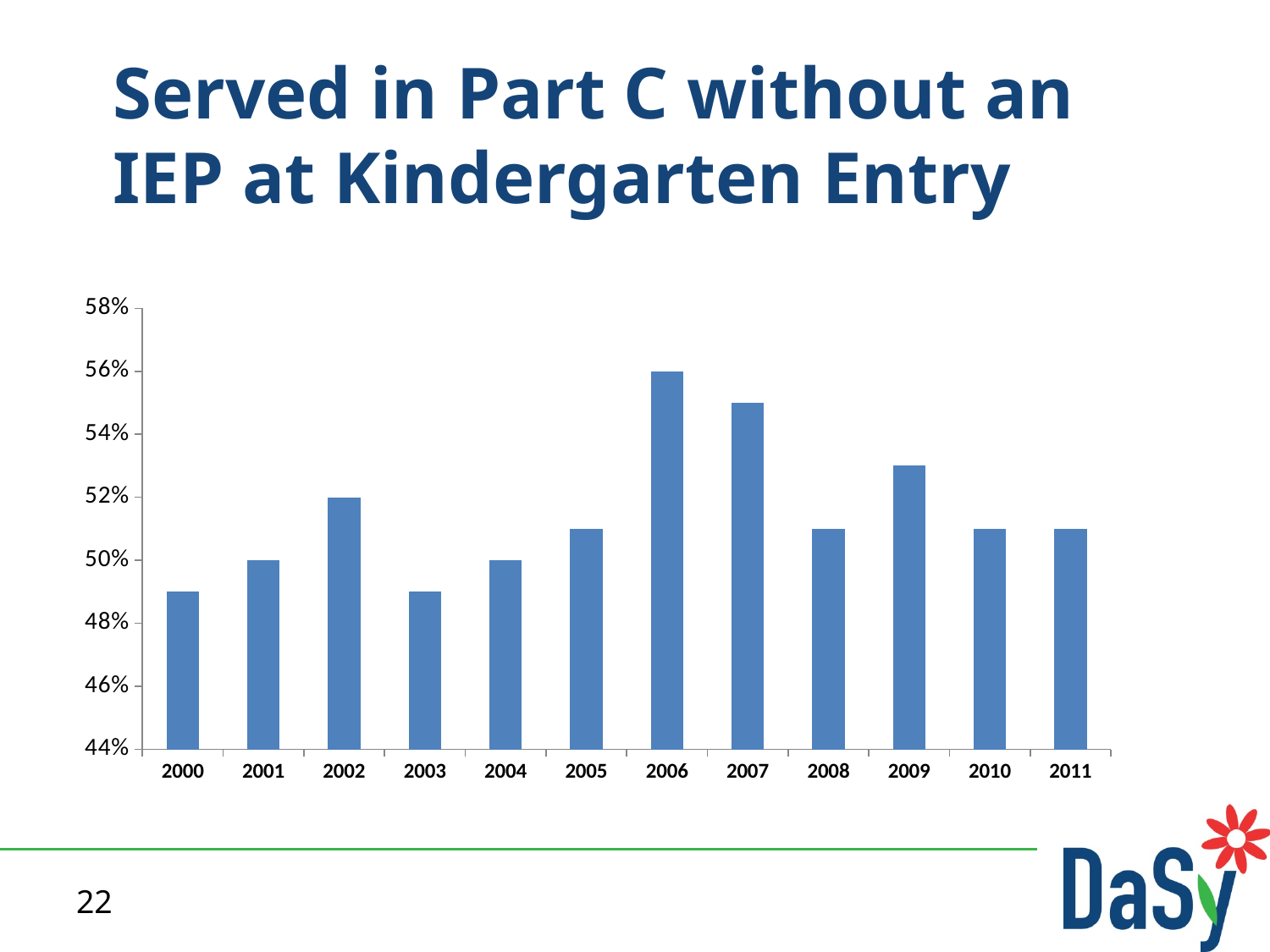
Which is larger, the value for 2002 or the value for 2003? 2002 Is the value for 2007 greater or less than 54%? greater Is the value for 2009 greater or less than 52%? greater Is the value for 2000 greater or less than 50%? less Do the values rise or fall from 2006 to 2008? fall What is the value for 2002? 52% How many years are shown on the x axis of the chart? 12 Which year has the highest value in the chart? 2006 What type of chart is shown on the slide? bar chart What is the value for 2006? 56% What is the value for 2001? 50% What is the difference between the values for 2006 and 2002? 4 percentage points